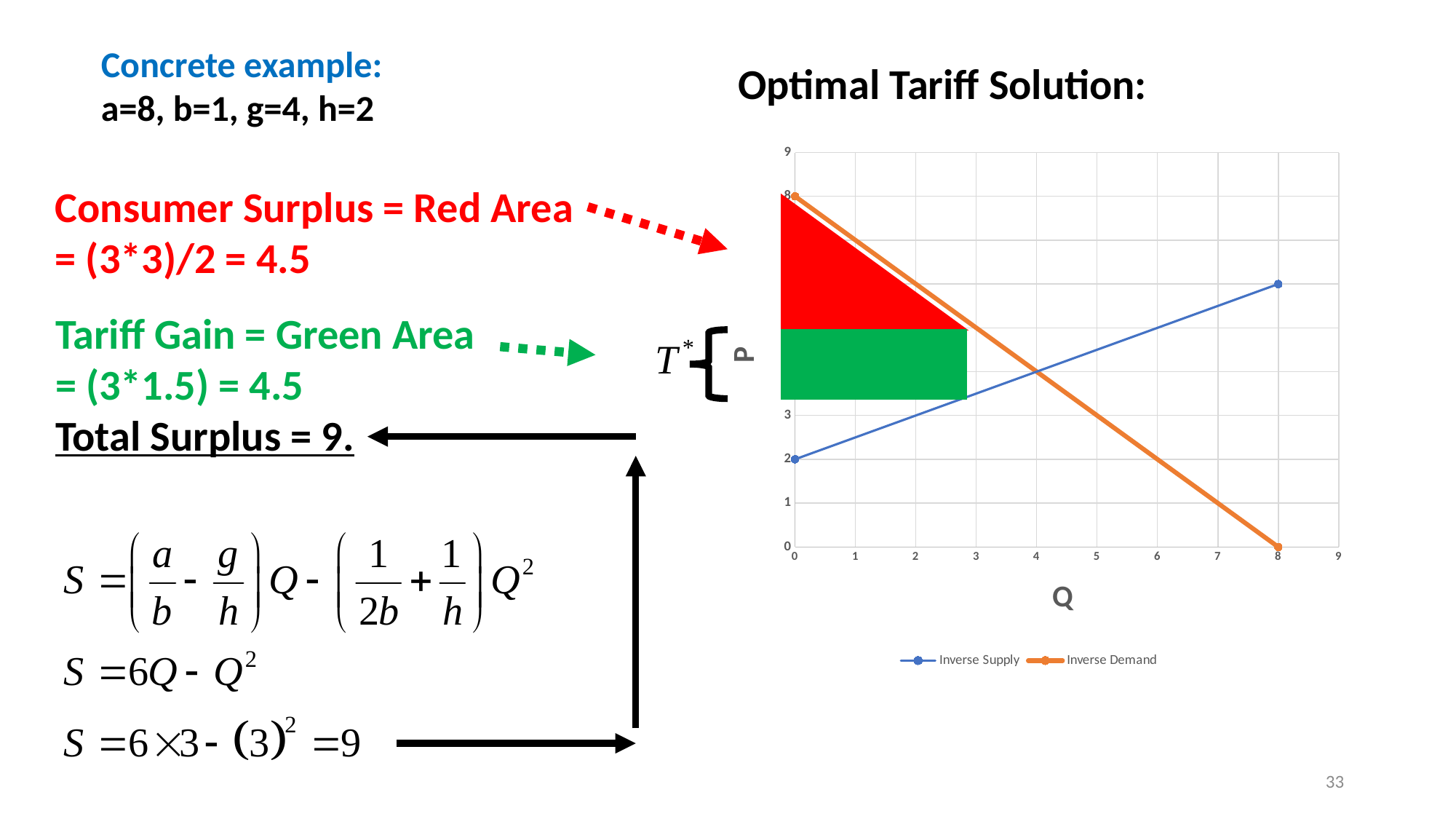
What is the difference between Inverse Demand and Inverse Supply at Q = 0? 6 Does the Inverse Demand line rise or fall as Q increases? fall How many series does the legend of the chart list? 2 At Q = 0, which series has the higher value, Inverse Supply or Inverse Demand? Inverse Demand What is the value of Inverse Demand at Q = 0? 8 Is the value of Inverse Demand at Q = 2 greater or less than 5? greater Does the Inverse Supply line rise or fall as Q increases? rise What is the value of Inverse Supply at Q = 8? 6 What is the label on the horizontal axis of the chart? Q What type of chart is shown under the title "Optimal Tariff Solution:"? line chart What is the value of Inverse Demand at Q = 8? 0 What is the value of Inverse Supply at Q = 0? 2